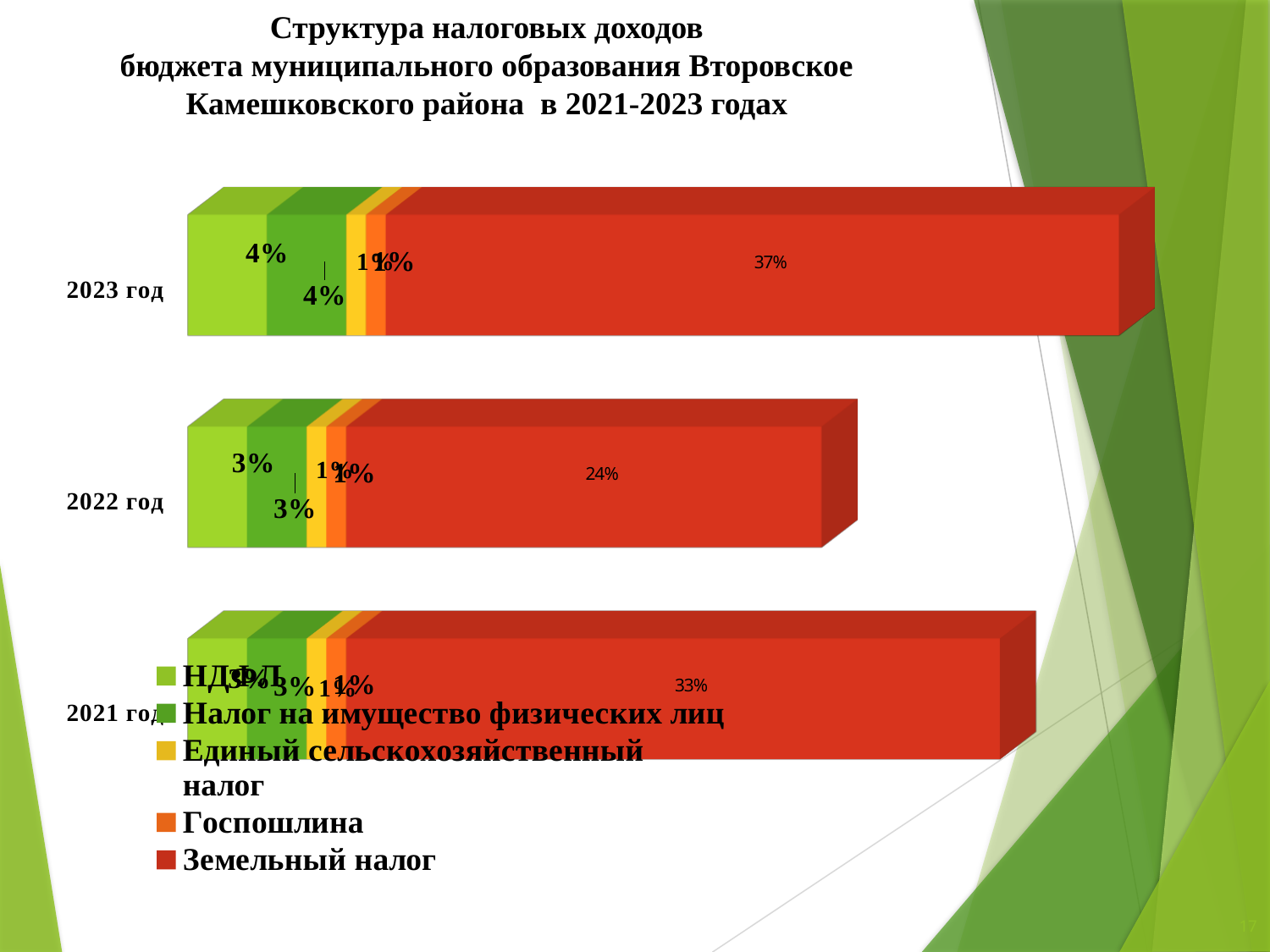
In which year is the value for Земельный налог the lowest? 2022 год What is the total of the stacked bar for 2023 год? 47% What is the value for НДФЛ in 2023 год? 4% In which year is the value for Земельный налог the highest? 2023 год What is the value for Земельный налог in 2022 год? 24% What is the difference between the Земельный налог values for 2023 год and 2022 год? 13 percentage points What kind of chart is shown on the slide? Stacked bar chart How many series does the legend list? 5 What is the value for Земельный налог in 2023 год? 37% Which year has the larger value for Земельный налог, 2021 год or 2022 год? 2021 год How many years (categories) are plotted on the chart? 3 What is the value for Земельный налог in 2021 год? 33%